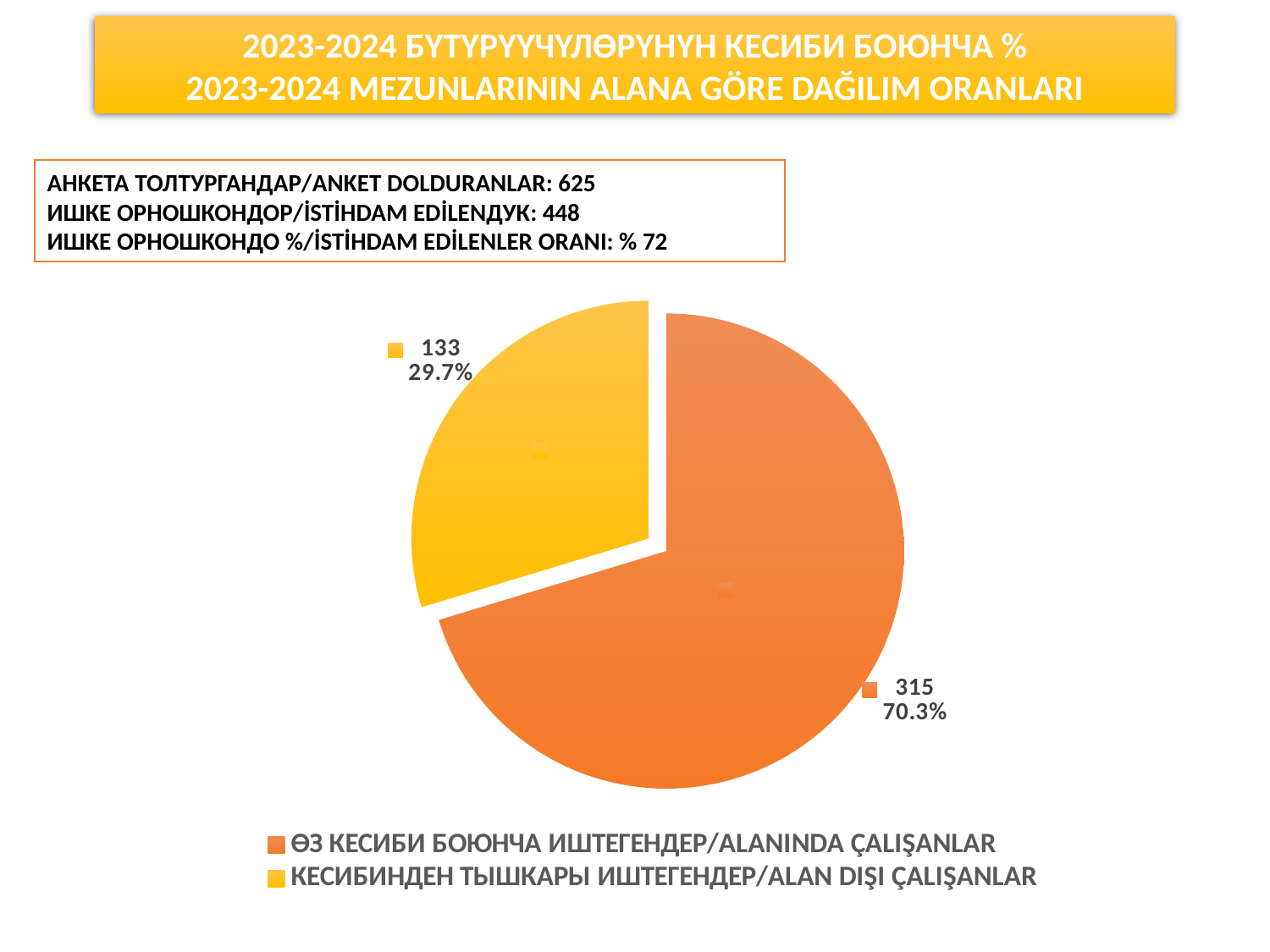
What is the value for КЕСИБИНДЕН ТЫШКАРЫ ИШТЕГЕНДЕР/ALAN DIŞI ÇALIŞANLAR? 133 Which category has the largest slice in the pie chart? ӨЗ КЕСИБИ БОЮНЧА ИШТЕГЕНДЕР/ALANINDA ÇALIŞANLAR How many entries does the legend of the pie chart list? 2 What share of the pie does ALANINDA ÇALIŞANLAR represent? 70.3% What is the value for ӨЗ КЕСИБИ БОЮНЧА ИШТЕГЕНДЕР/ALANINDA ÇALIŞANLAR? 315 How many slices does the pie chart have? 2 What is the difference between the values for ALANINDA ÇALIŞANLAR and ALAN DIŞI ÇALIŞANLAR? 182 What type of chart is shown on the slide? pie chart Which is larger: the value for ALANINDA ÇALIŞANLAR or the value for ALAN DIŞI ÇALIŞANLAR? ALANINDA ÇALIŞANLAR What colour is the slice for КЕСИБИНДЕН ТЫШКАРЫ ИШТЕГЕНДЕР/ALAN DIŞI ÇALIŞANLAR? yellow What share of the pie does ALAN DIŞI ÇALIŞANLAR represent? 29.7% Which category has the smallest slice in the pie chart? КЕСИБИНДЕН ТЫШКАРЫ ИШТЕГЕНДЕР/ALAN DIŞI ÇALIŞANLAR